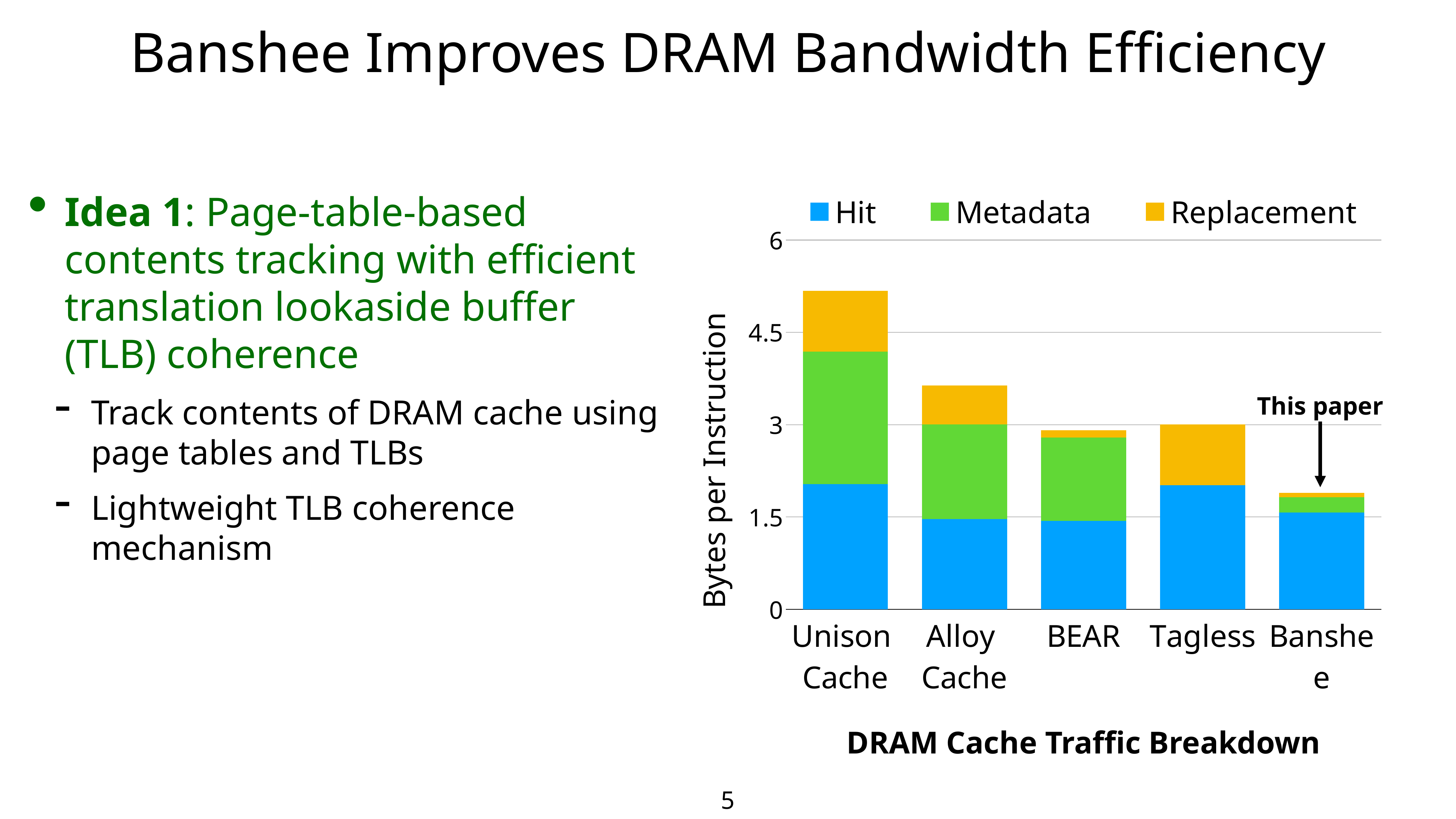
Which category has the lowest total bytes per instruction? Banshee Which category has the highest total bytes per instruction? Unison Cache How many series does the legend list in the DRAM Cache Traffic Breakdown chart? 3 How many categories are shown on the x axis of the DRAM Cache Traffic Breakdown chart? 5 What kind of chart is shown on the slide? bar chart What is the label on the y axis of the chart? Bytes per Instruction Which bar does the annotation "This paper" point to? Banshee Is the total bar for Unison Cache greater or less than 4.5 bytes per instruction? greater Is the total bar for Banshee greater or less than 3 bytes per instruction? less Which has a larger total bar, Alloy Cache or Banshee? Alloy Cache Which has a larger total bar, Unison Cache or Alloy Cache? Unison Cache Is the total bar for Alloy Cache greater or less than 3 bytes per instruction? greater